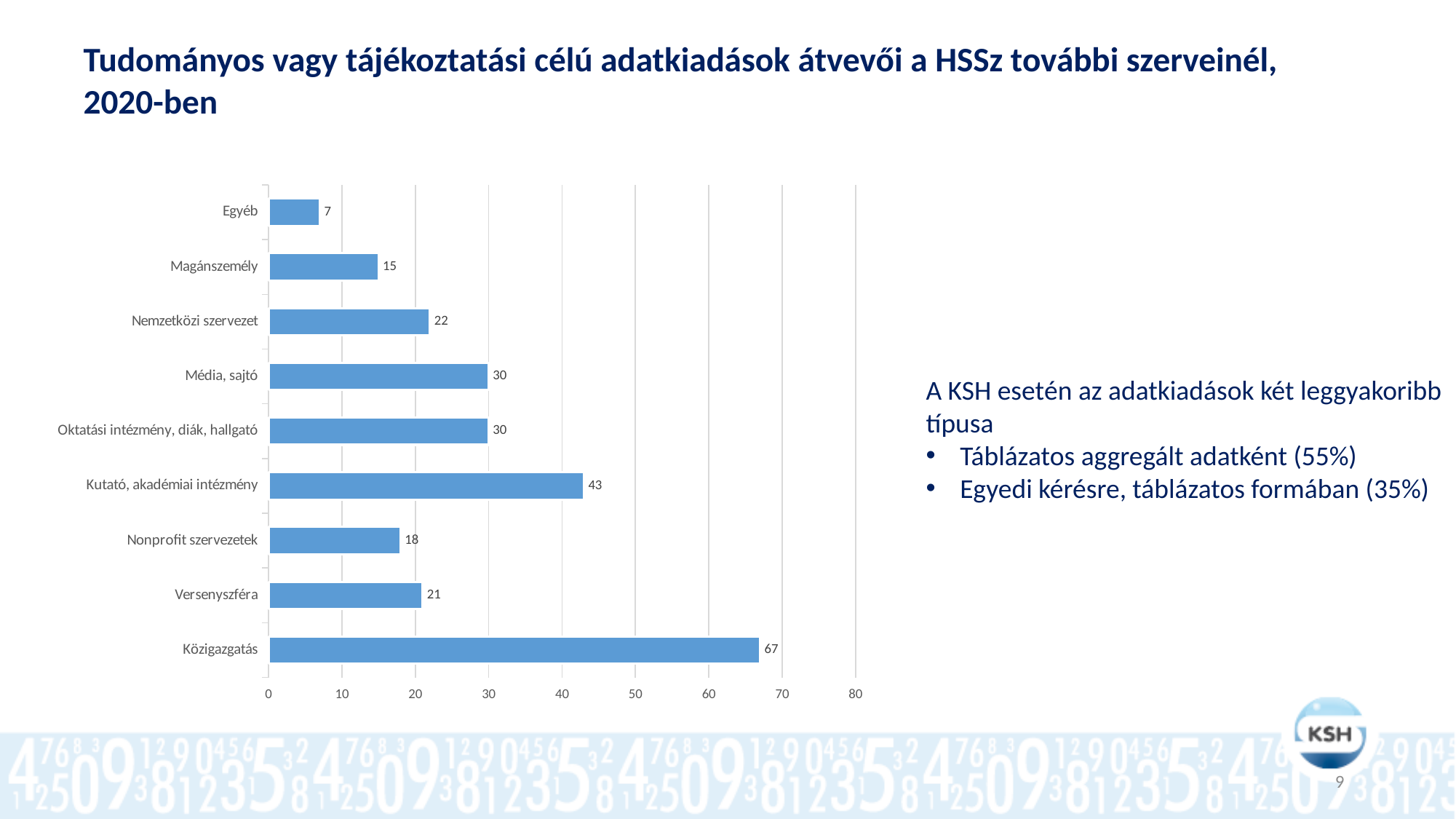
What is the highest value shown on the x axis? 80 Is the value for Nemzetközi szervezet greater or less than 30? less How many categories are shown in the chart? 9 What is the value for Közigazgatás? 67 Which category has the highest value? Közigazgatás What is the value for Magánszemély? 15 What is the value for Média, sajtó? 30 Which is larger, the value for Versenyszféra or the value for Nonprofit szervezetek? Versenyszféra What is the value for Kutató, akadémiai intézmény? 43 What kind of chart is shown on the slide? bar chart Which category has the lowest value? Egyéb What is the difference between the values for Közigazgatás and Kutató, akadémiai intézmény? 24